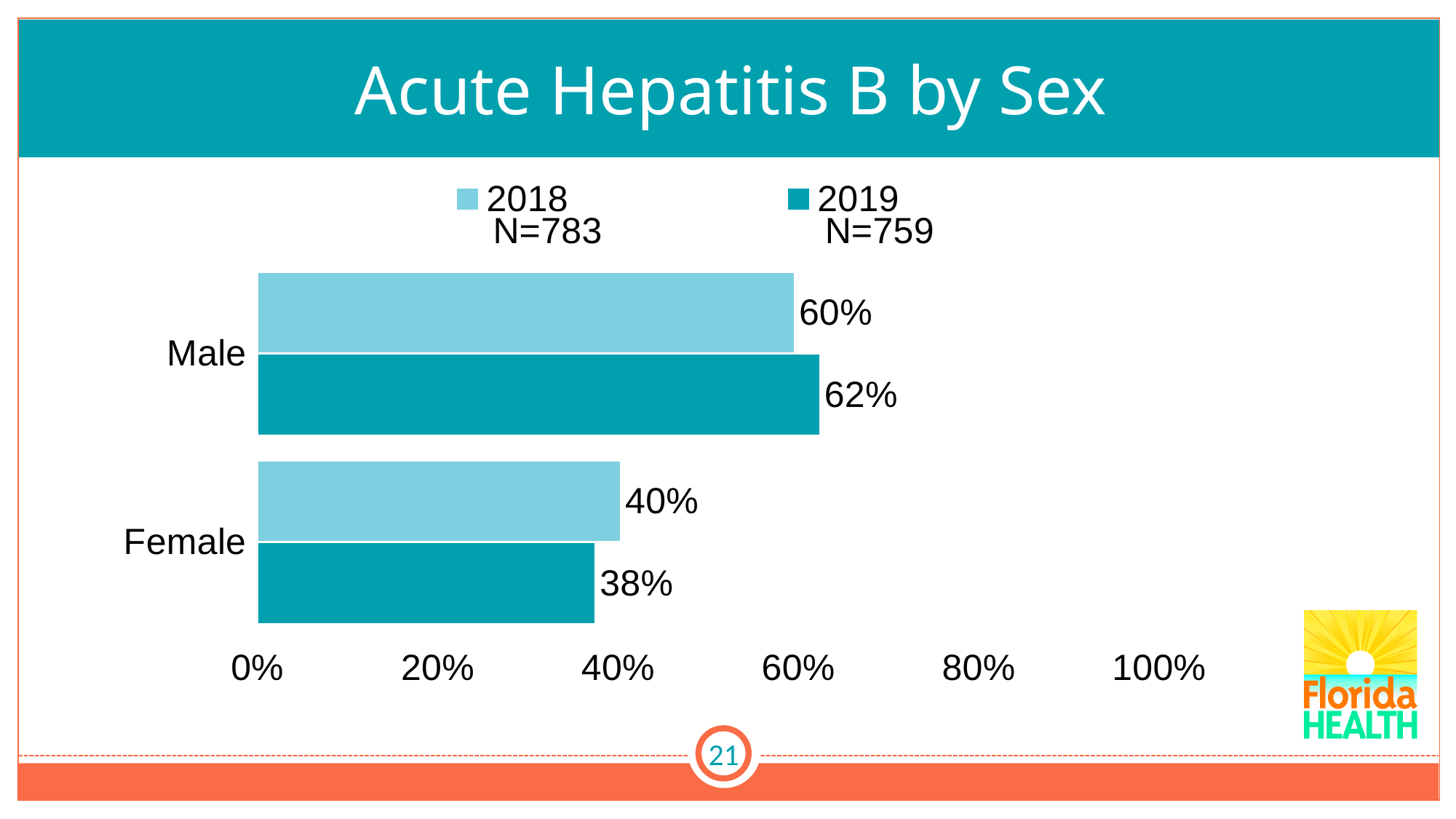
Was the male percentage higher in 2018 or 2019? 2019 Which sex had the higher share of acute hepatitis B cases in 2019? Male Which sex had the lower share of acute hepatitis B cases in 2018? Female What percentage of acute hepatitis B cases were male in 2019? 62% What is the N value shown for 2019 in the legend? N=759 What percentage of acute hepatitis B cases were female in 2019? 38% What percentage of acute hepatitis B cases were female in 2018? 40% What kind of chart is shown on the slide? Bar chart How many series does the legend list? 2 What is the difference between the male and female percentages in 2019? 24% What is the difference between the 2018 and 2019 female percentages? 2% What percentage of acute hepatitis B cases were male in 2018? 60%